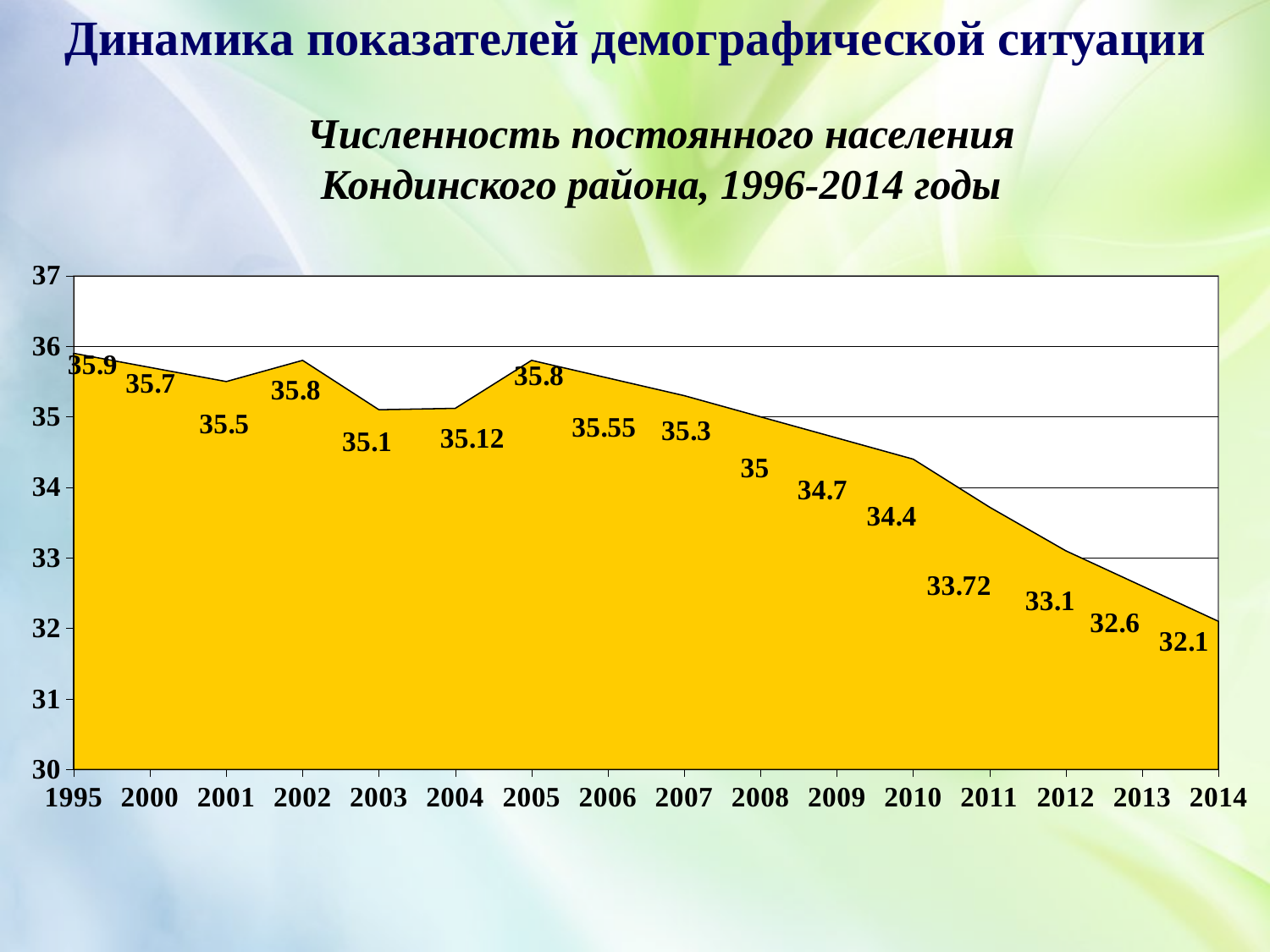
What is the value for 2011? 33.72 Do the values generally rise or fall from 2005 to 2014? fall What kind of chart is this? area chart What is the value for 2004? 35.12 Which year has the lowest value? 2014 Which year has the highest value? 1995 What is the difference between the values for 1995 and 2014? 3.8 Is the value for 2012 greater or less than 34? less What is the value for 1995? 35.9 Which is larger, the value for 2002 or the value for 2003? 2002 How many years are shown on the x axis? 16 What is the value for 2014? 32.1